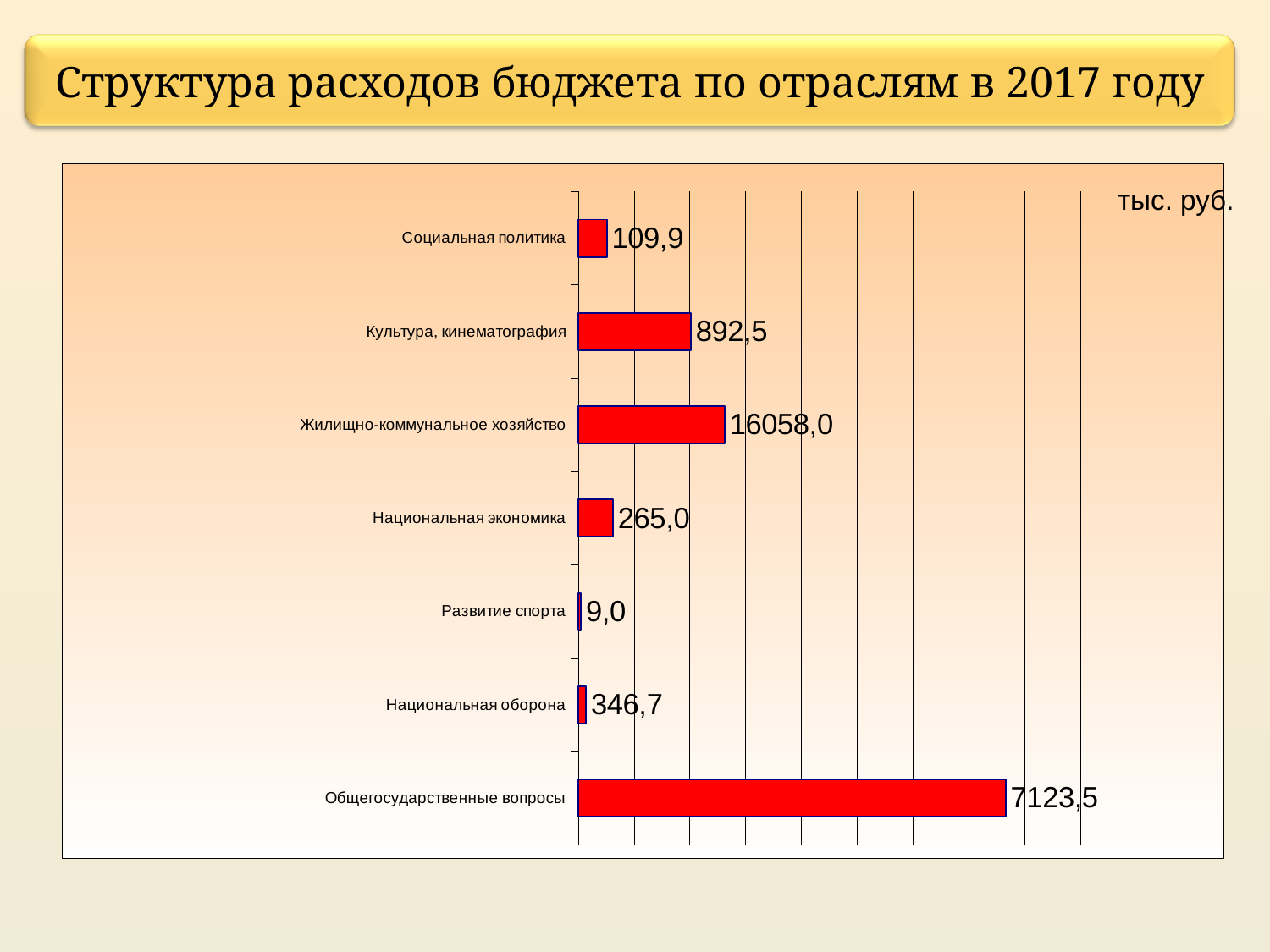
What is the value for Жилищно-коммунальное хозяйство? 16058,0 How many categories are shown in the chart? 7 What is the value for Национальная экономика? 265,0 What is the value for Национальная оборона? 346,7 What is the value for Культура, кинематография? 892,5 Which is larger, the value for Национальная экономика or the value for Социальная политика? Национальная экономика What kind of chart is shown on the slide? Bar chart What is the value for Развитие спорта? 9,0 What is the value for Общегосударственные вопросы? 7123,5 What is the value for Социальная политика? 109,9 Which category has the lowest value? Развитие спорта What is the difference between the values for Культура, кинематография and Социальная политика? 782,6